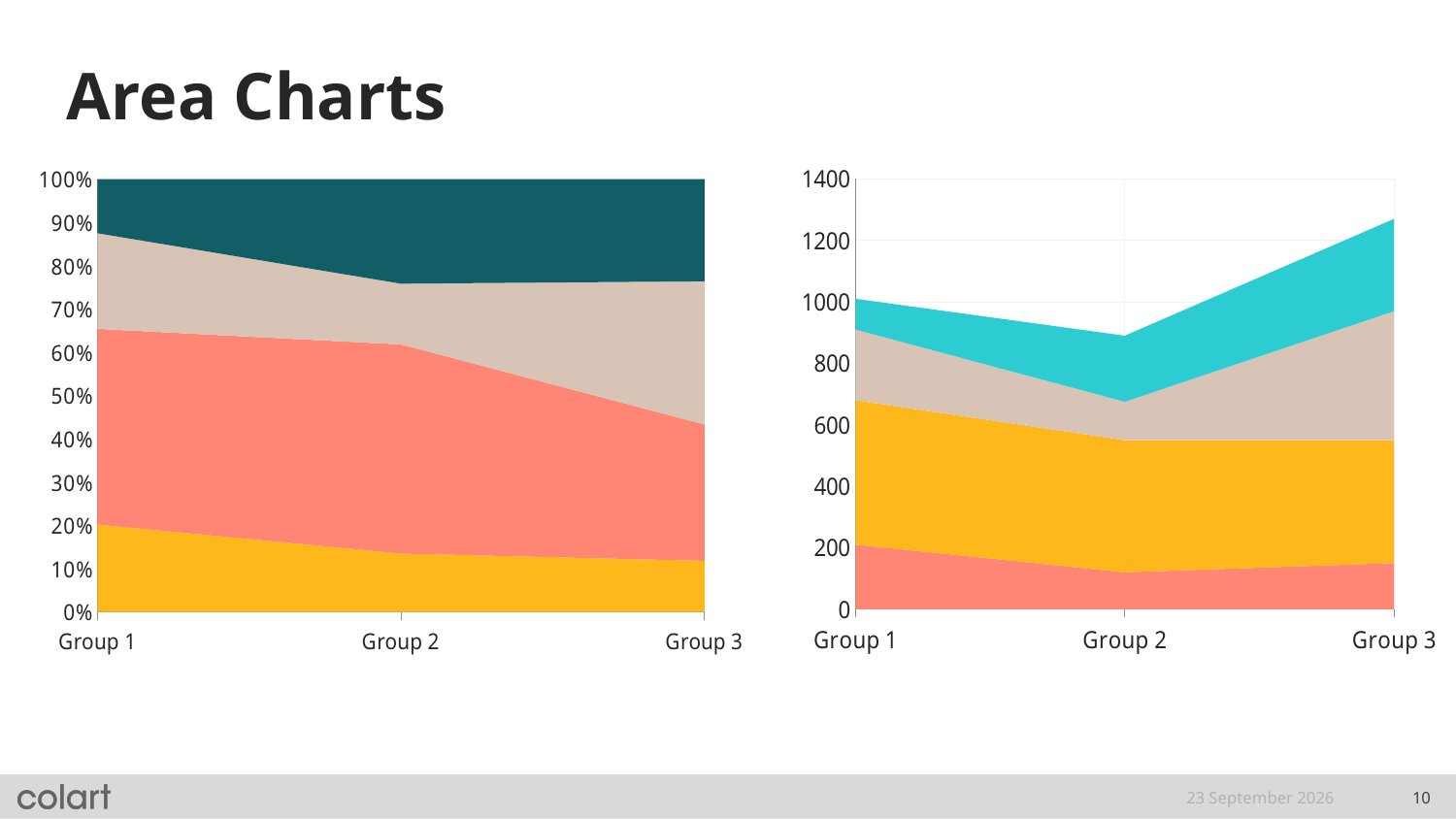
In the chart on the right, which group has the highest stacked total? Group 3 What kind of chart is the chart on the left of the slide? Area chart In the chart on the right, is the stacked total for Group 2 greater or less than 1000? less What kind of chart is the chart on the right of the slide? Area chart In the chart on the right, how many stacked bands (series) are plotted? 4 In the chart on the left, how many categories are shown on the x axis? 3 In the chart on the right, is the stacked total for Group 3 greater or less than 1200? greater In the chart on the left, how many stacked bands (series) are plotted? 4 In the chart on the right, which group has the lowest stacked total? Group 2 In the chart on the left, is the bottom (yellow) band's value for Group 1 greater or less than 30%? less In the chart on the left, does the bottom (yellow) band rise or fall from Group 1 to Group 3? fall